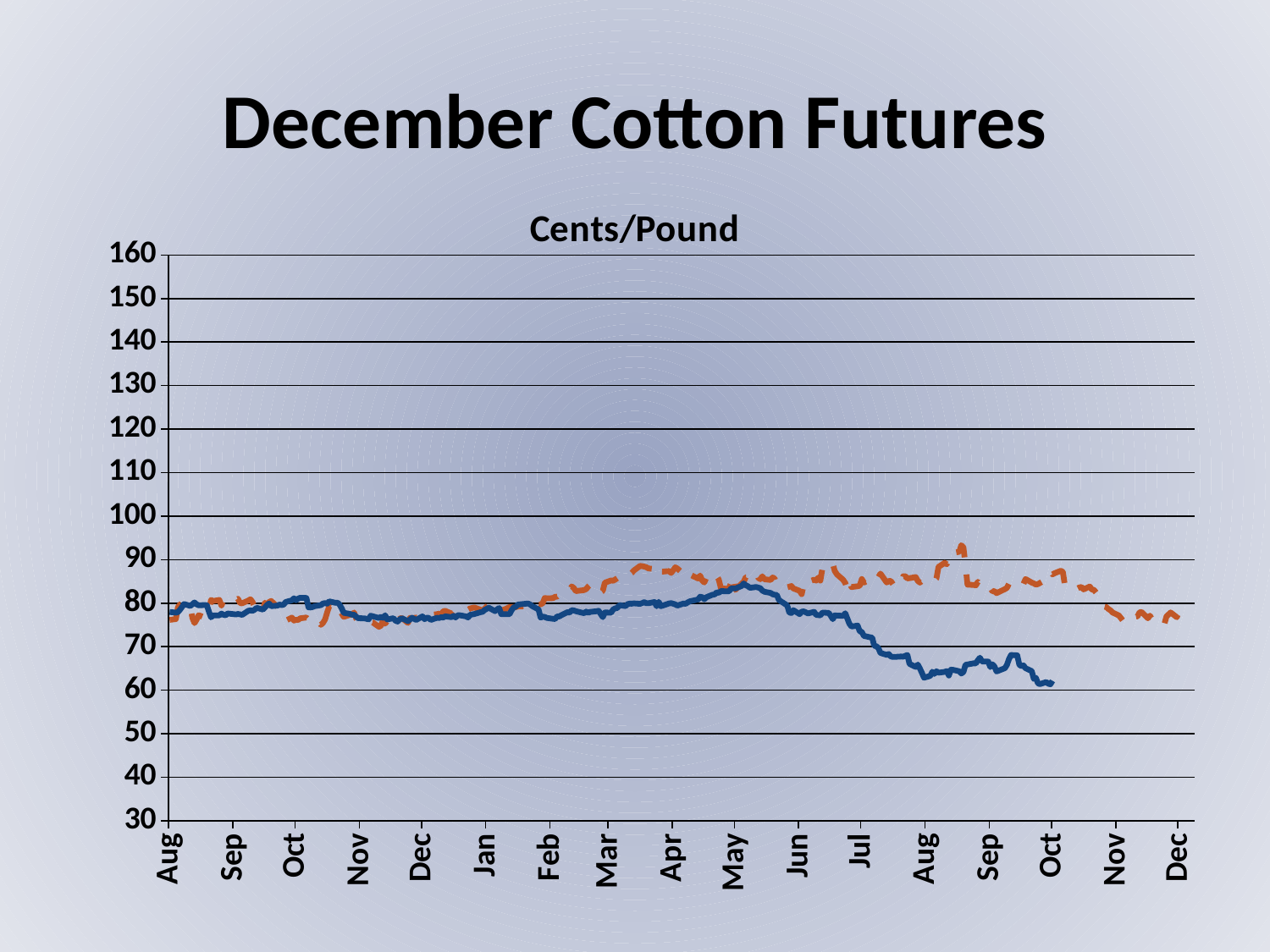
Does the solid blue line rise or fall between May and the second Oct? fall At the second Aug, which line is higher, the solid blue line or the dashed orange line? dashed orange line What is the title of the chart? Cents/Pound How many month labels are shown along the x axis? 17 Is the value of the dashed orange line at the final Dec greater or less than 80? less What is the highest value shown on the y axis? 160 What kind of chart is shown on the slide? line chart Is the value of the dashed orange line at Apr greater or less than 80? greater Is the value of the solid blue line at May greater or less than 80? greater How many lines are plotted on the chart? 2